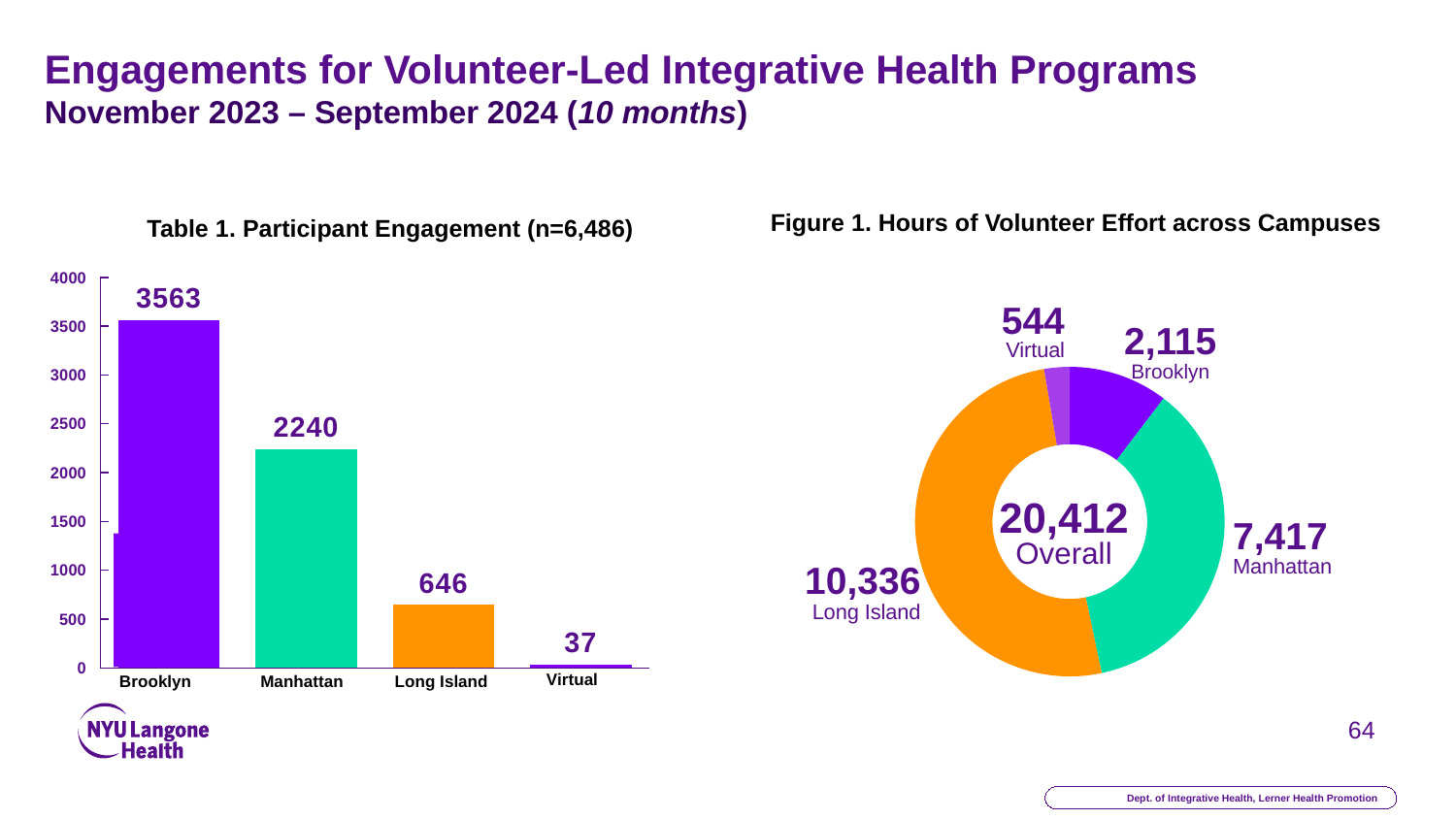
In the donut chart titled 'Figure 1. Hours of Volunteer Effort across Campuses', how many hours are shown for Long Island? 10,336 In the bar chart titled 'Table 1. Participant Engagement', which campus has the lowest participant engagement? Virtual In the bar chart titled 'Table 1. Participant Engagement', which campus has the highest participant engagement? Brooklyn In the bar chart titled 'Table 1. Participant Engagement', how many campus categories are shown? 4 What kind of chart is 'Table 1. Participant Engagement'? Bar chart In the bar chart titled 'Table 1. Participant Engagement', what is the difference between the Brooklyn and Manhattan values? 1323 What kind of chart is 'Figure 1. Hours of Volunteer Effort across Campuses'? Donut (pie) chart In the bar chart titled 'Table 1. Participant Engagement', what is the value for Manhattan? 2240 In the donut chart titled 'Figure 1. Hours of Volunteer Effort across Campuses', which has more volunteer hours, Manhattan or Brooklyn? Manhattan In the bar chart titled 'Table 1. Participant Engagement', do the values rise or fall from Brooklyn to Virtual along the x axis? Fall In the donut chart titled 'Figure 1. Hours of Volunteer Effort across Campuses', which campus has the fewest volunteer hours? Virtual In the donut chart titled 'Figure 1. Hours of Volunteer Effort across Campuses', what is the overall total of volunteer hours shown in the center? 20,412